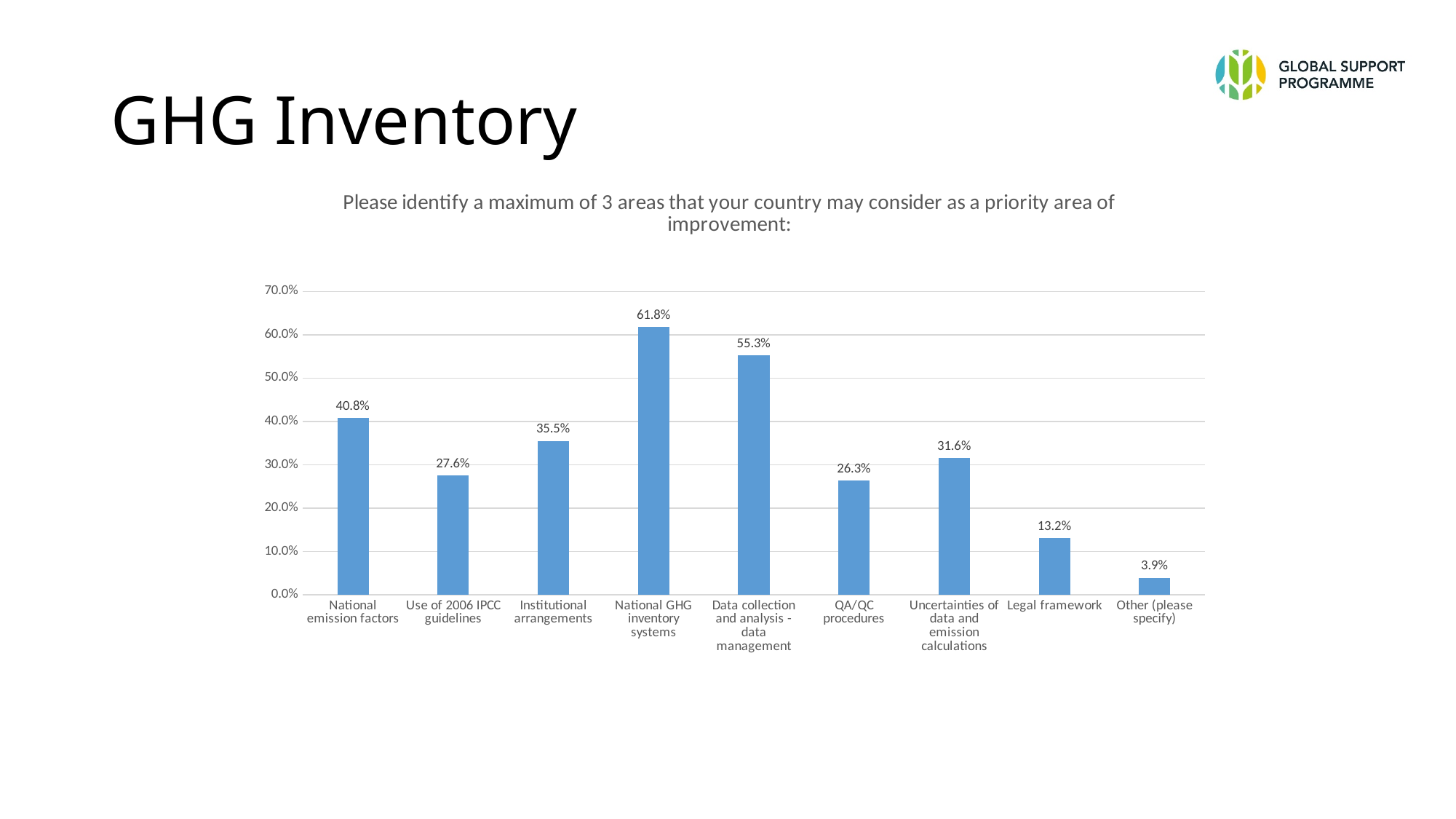
Which is larger, QA/QC procedures or Uncertainties of data and emission calculations? Uncertainties of data and emission calculations How many categories are shown on the chart? 9 Which category has the highest value? National GHG inventory systems What is the value for Use of 2006 IPCC guidelines? 27.6% What is the value for National GHG inventory systems? 61.8% Is the value for National emission factors greater or less than 40.0%? greater What kind of chart is shown on the slide? Bar chart Which category has the lowest value? Other (please specify) What is the value for Legal framework? 13.2% What is the title of the chart? Please identify a maximum of 3 areas that your country may consider as a priority area of improvement: What is the difference between National emission factors and Institutional arrangements? 5.3% What is the value for Data collection and analysis - data management? 55.3%